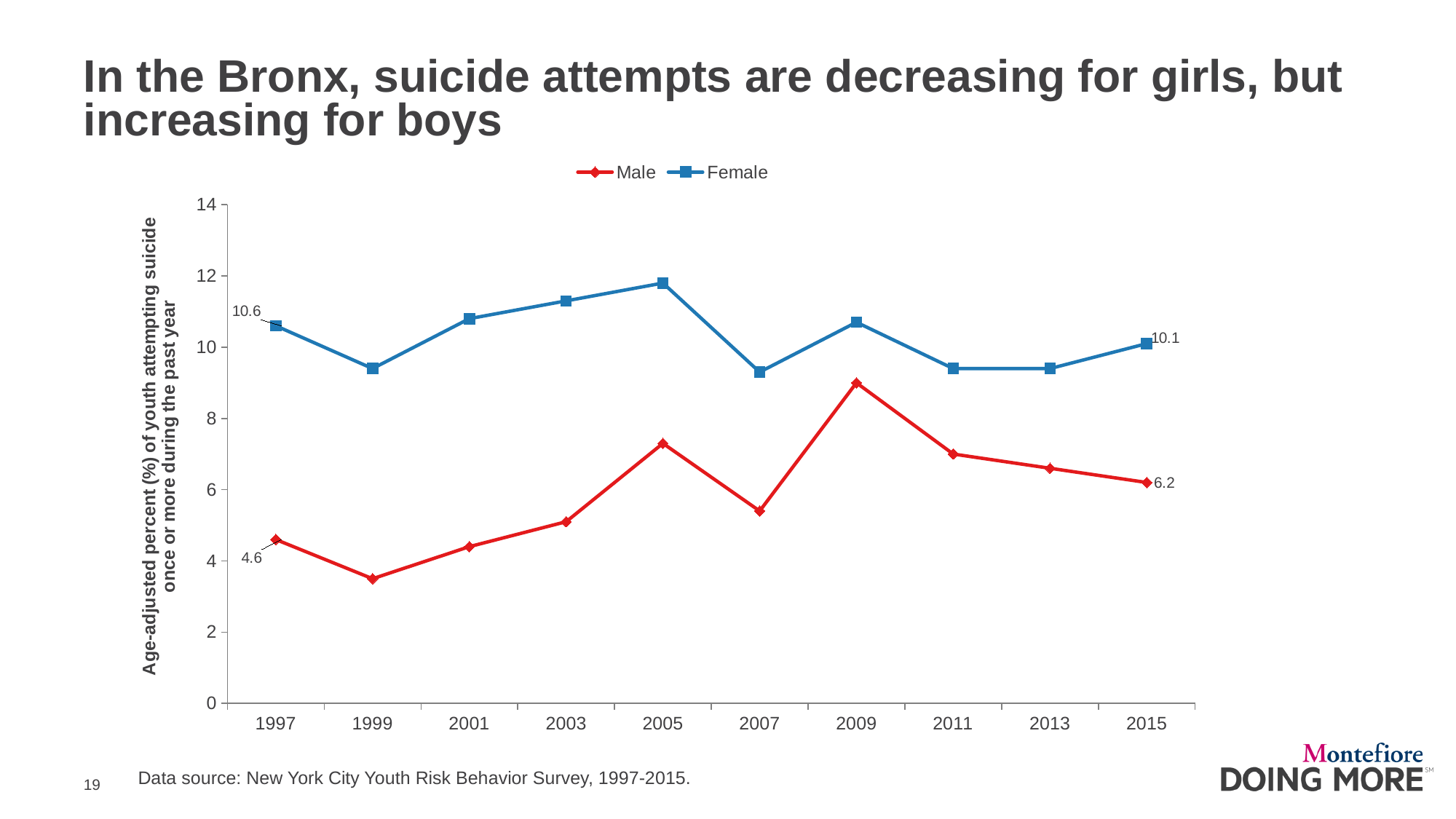
How many years are plotted on the x axis? 10 What is the value for Female in 1997? 10.6 In which year does the Male series reach its highest value? 2009 In which year does the Male series reach its lowest value? 1999 How many series does the legend list? 2 What is the difference between the Female and Male values in 1997? 6.0 In which year does the Female series reach its highest value? 2005 Is the value for Male in 2009 greater or less than 8? greater What is the value for Male in 1997? 4.6 What is the value for Female in 2015? 10.1 What is the difference between the Female and Male values in 2015? 3.9 What kind of chart is shown on the slide? line chart